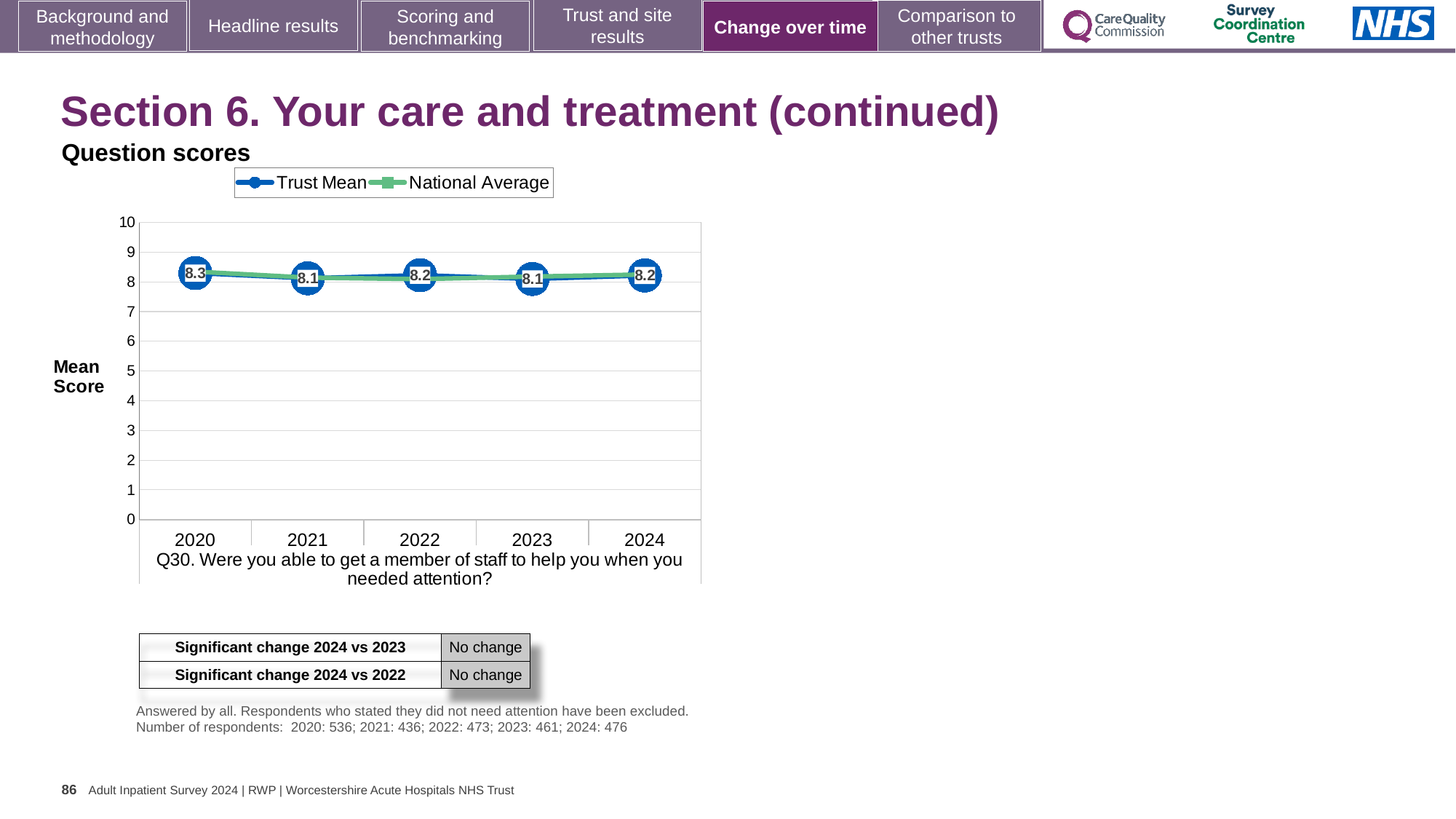
In which year is the Trust Mean score highest? 2020 Is the National Average value for 2024 greater or less than 7? greater What is the title of the y axis? Mean Score Does the Trust Mean score rise or fall from 2020 to 2021? Fall What is the Trust Mean score for 2023? 8.1 What is the difference between the Trust Mean scores for 2020 and 2021? 0.2 What kind of chart is shown on the slide? Line chart How many series does the legend list? 2 How many years are plotted on the x axis? 5 What is the Trust Mean score for 2020? 8.3 What is the Trust Mean score for 2024? 8.2 Which year has the larger Trust Mean score, 2022 or 2023? 2022